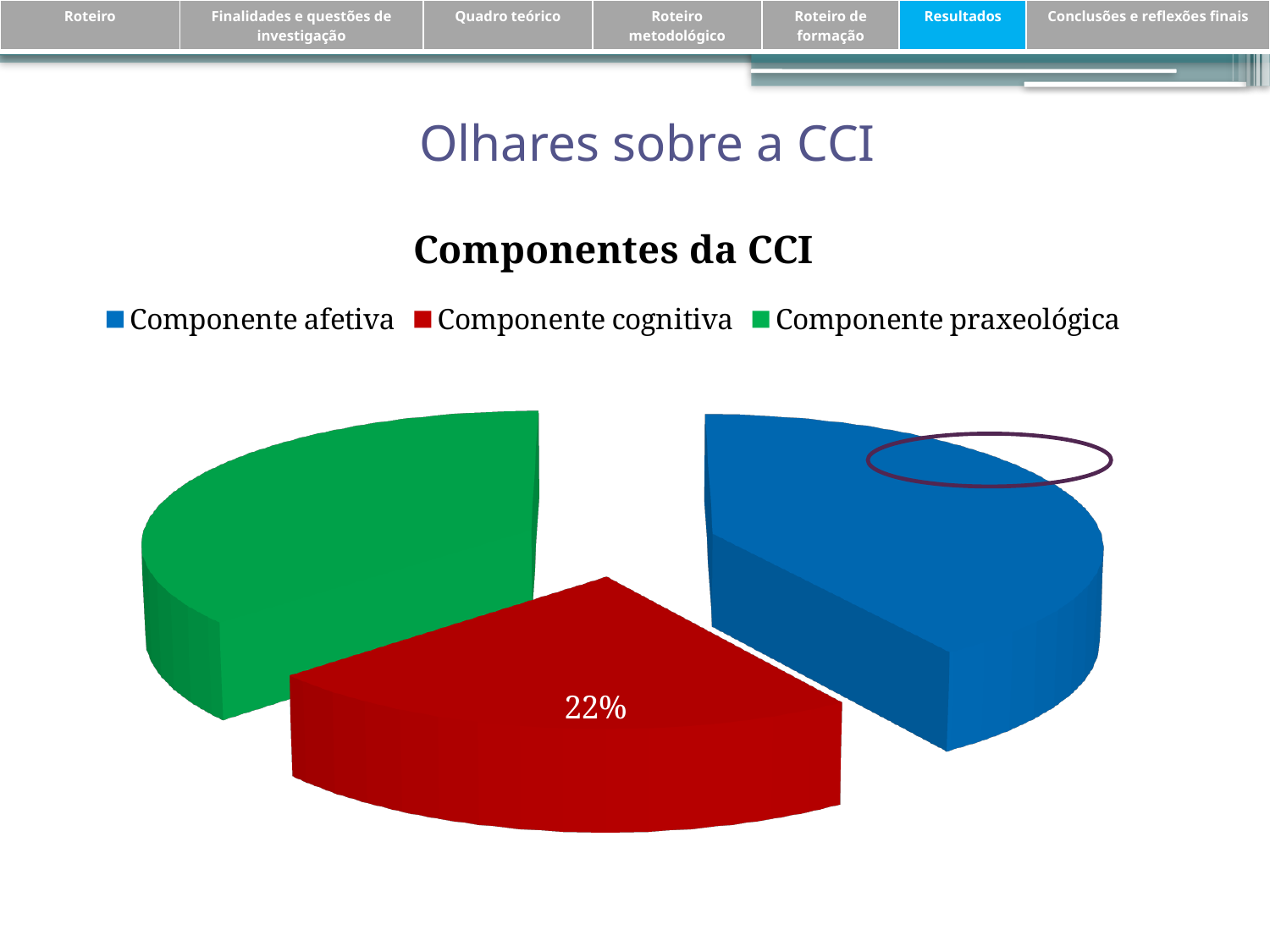
Which component has the smallest slice of the pie? Componente cognitiva What share of the pie does Componente cognitiva represent? 22% Which slice is larger, Componente cognitiva or Componente afetiva? Componente afetiva Which slice is larger, Componente cognitiva or Componente praxeológica? Componente praxeológica What kind of chart is shown on the slide? pie chart How many slices does the pie chart have? 3 How many entries does the legend list? 3 Which colour represents Componente praxeológica in the chart? green What is the title of the chart? Componentes da CCI What percentage is shown for Componente cognitiva? 22%